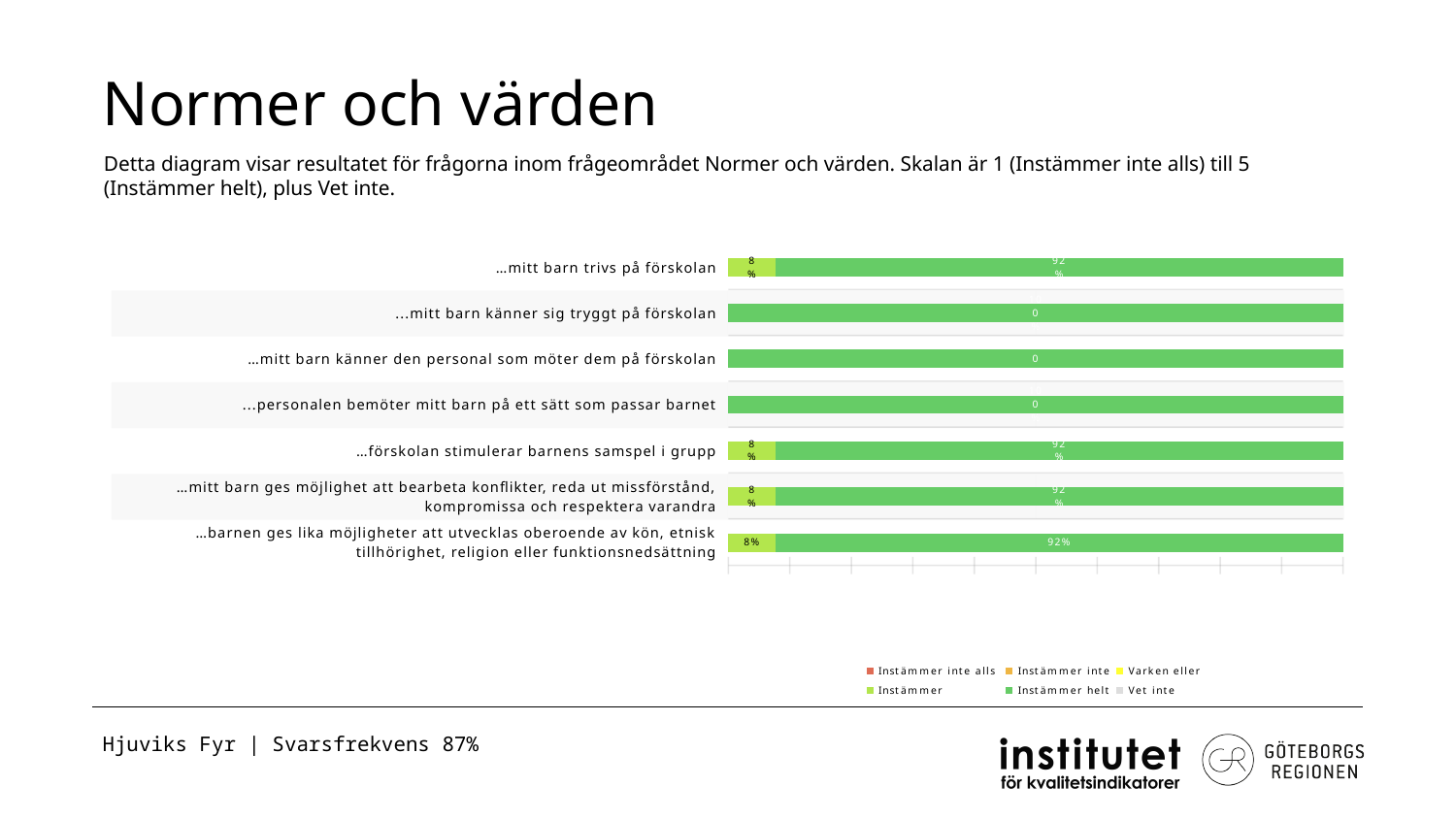
What is the 'Instämmer helt' value for '…barnen ges lika möjligheter att utvecklas oberoende av kön, etnisk tillhörighet, religion eller funktionsnedsättning'? 92% What is the 'Instämmer helt' value for '…mitt barn trivs på förskolan'? 92% For '…mitt barn trivs på förskolan', what is the difference between the 'Instämmer helt' value and the 'Instämmer' value? 84 percentage points What kind of chart is shown on the slide? bar chart How many series does the chart legend list? 6 How many categories (statements) are plotted in the chart? 7 What is the total of the 'Instämmer' and 'Instämmer helt' segments for '…barnen ges lika möjligheter att utvecklas oberoende av kön, etnisk tillhörighet, religion eller funktionsnedsättning'? 100% For '…mitt barn ges möjlighet att bearbeta konflikter, reda ut missförstånd, kompromissa och respektera varandra', which is larger: 'Instämmer' or 'Instämmer helt'? Instämmer helt Which legend entry is shown in dark green? Instämmer helt What is the 'Instämmer' value for '…förskolan stimulerar barnens samspel i grupp'? 8% What is the 'Instämmer' value for '…barnen ges lika möjligheter att utvecklas oberoende av kön, etnisk tillhörighet, religion eller funktionsnedsättning'? 8% What is the title of the slide containing the chart? Normer och värden